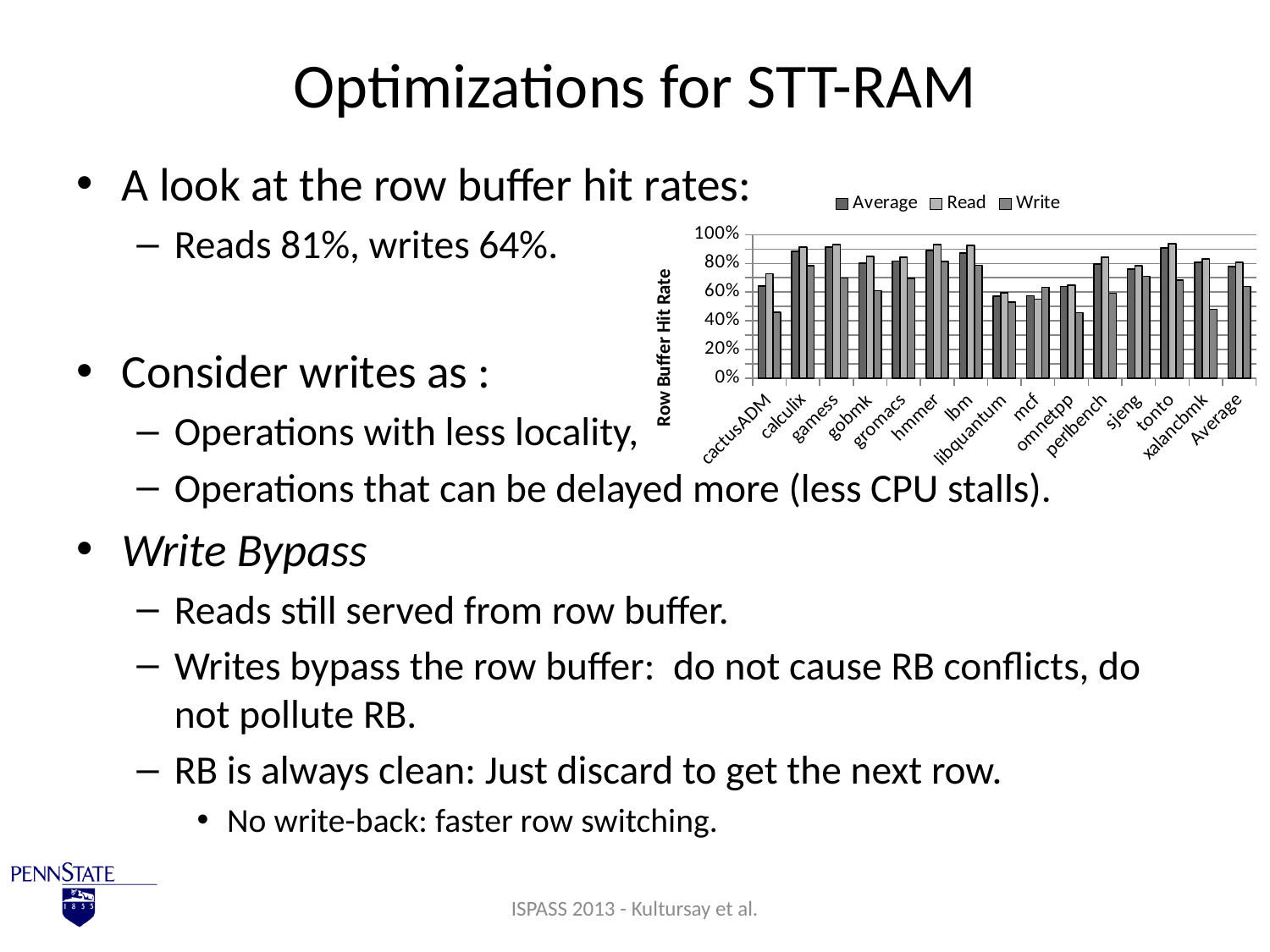
Is the Write value for xalancbmk greater or less than 60%? less How many categories are shown along the x axis of the chart? 15 What is the label of the chart's vertical axis? Row Buffer Hit Rate Which series are listed in the chart's legend? Average, Read, Write How many series does the chart's legend list? 3 Is the Read value for cactusADM greater or less than 60%? greater For omnetpp, which is larger, the Read value or the Write value? Read Is the Read value for gamess greater or less than 80%? greater For cactusADM, which is larger, the Read value or the Write value? Read What kind of chart is shown on the slide? Bar chart